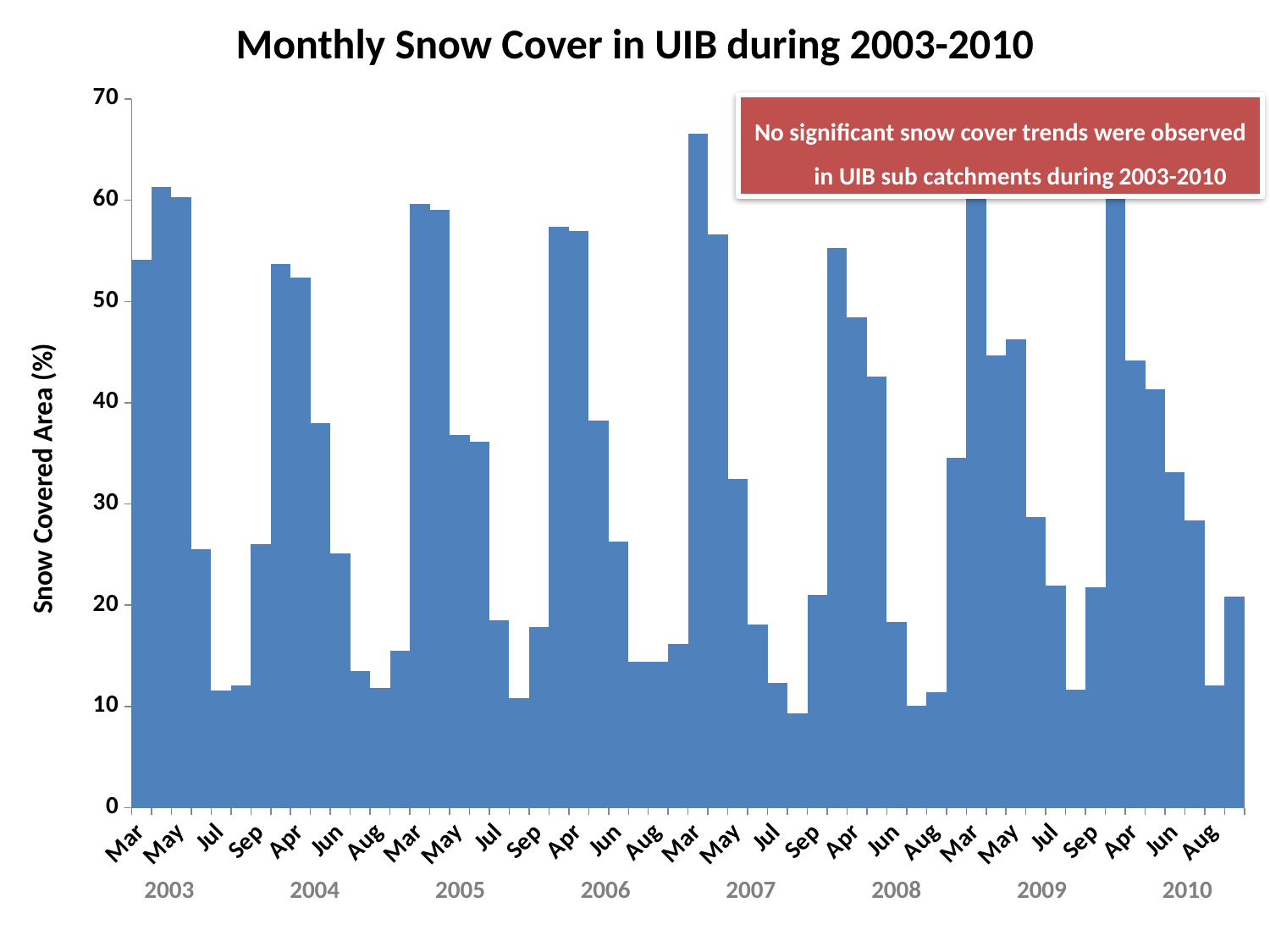
Is the value for Apr 2010 greater or less than 50? less Is the value for Mar 2003 greater or less than 50? greater What is the title of the chart? Monthly Snow Cover in UIB during 2003-2010 Within 2003, do the values rise or fall from Mar to Jul? fall Is the value for Jul 2003 greater or less than 20? less What is the label of the vertical axis? Snow Covered Area (%) What kind of chart is shown on the slide? bar chart How many years are labelled along the x axis? 8 Which is larger, the value for Mar 2003 or the value for Mar 2007? Mar 2007